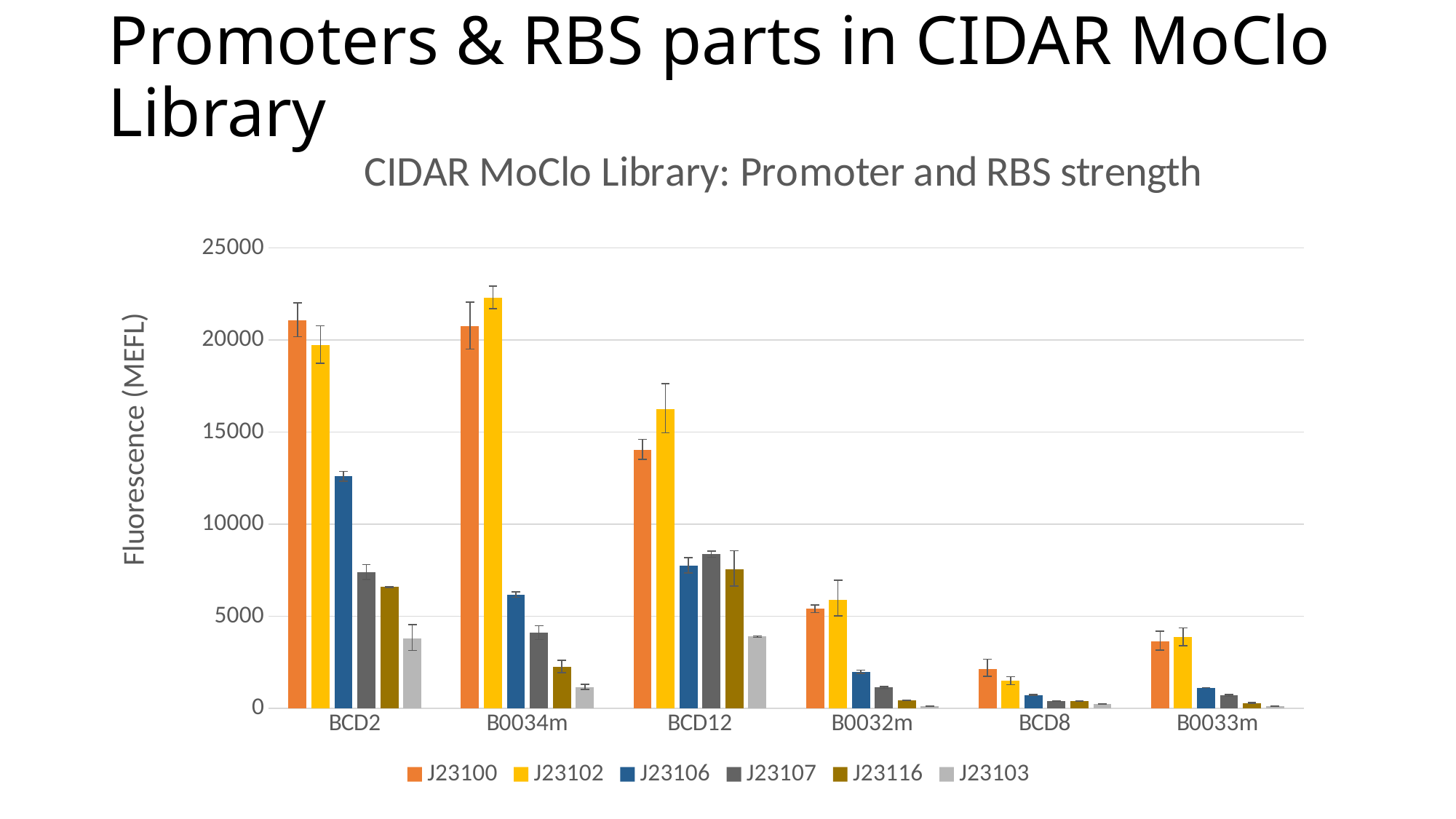
Which RBS category has the highest J23106 bar? BCD2 What is the label on the y axis of the chart? Fluorescence (MEFL) Is the value for J23100 at BCD8 greater or less than 5000? less Is the value for J23106 at BCD2 greater or less than 10000? greater What kind of chart is shown on the slide? bar chart How many series does the legend list? 6 How many RBS categories are shown along the x axis? 6 Is the value for J23102 at BCD12 greater or less than 15000? greater At BCD2, which is larger: the J23100 bar or the J23106 bar? J23100 Which is larger: the J23102 bar at B0034m or the J23102 bar at BCD12? B0034m Which series has the lowest bar at BCD2? J23103